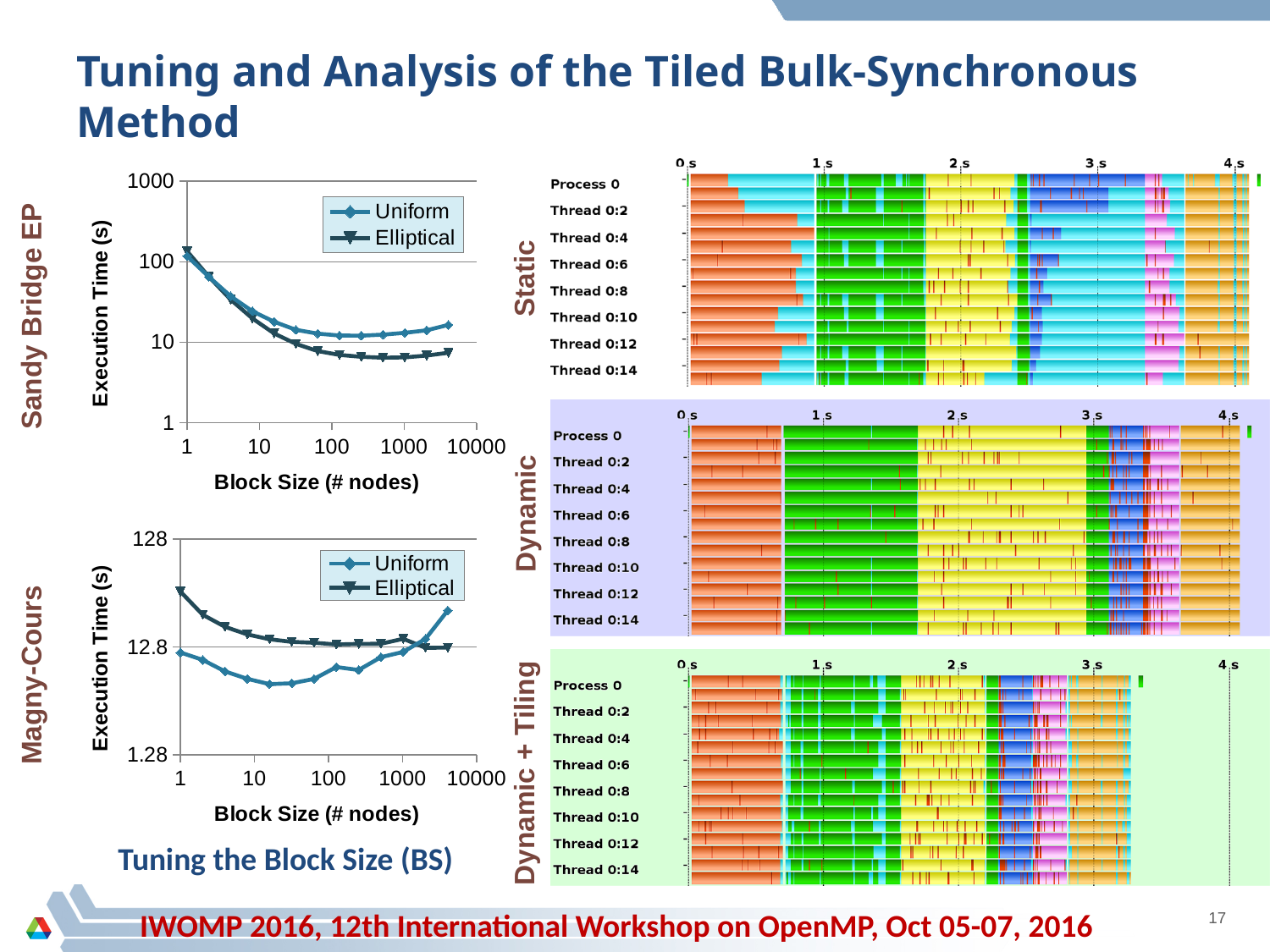
What kind of chart is the Sandy Bridge EP chart on the left? line chart Among the three timeline traces on the right (Static, Dynamic, Dynamic + Tiling), which one finishes earliest on the time axis? Dynamic + Tiling In the Sandy Bridge EP chart, at the largest block size plotted, which series has the higher execution time, Uniform or Elliptical? Uniform What are the two series named in the legend of the Magny-Cours chart? Uniform and Elliptical In the Sandy Bridge EP chart, does the Uniform execution time rise or fall as block size increases from 1 to 100? fall How many series does the legend of the Sandy Bridge EP chart list? 2 In the Sandy Bridge EP chart, is the Elliptical execution time at block size 1 greater or less than 100? greater In the Magny-Cours chart, at block size 1, which series has the higher execution time, Uniform or Elliptical? Elliptical What is the x-axis label of the Sandy Bridge EP chart? Block Size (# nodes) In the Magny-Cours chart, is the Elliptical execution time at block size 1 greater or less than 12.8? greater In the Magny-Cours chart, is the Uniform execution time at block size 10 greater or less than 12.8? less